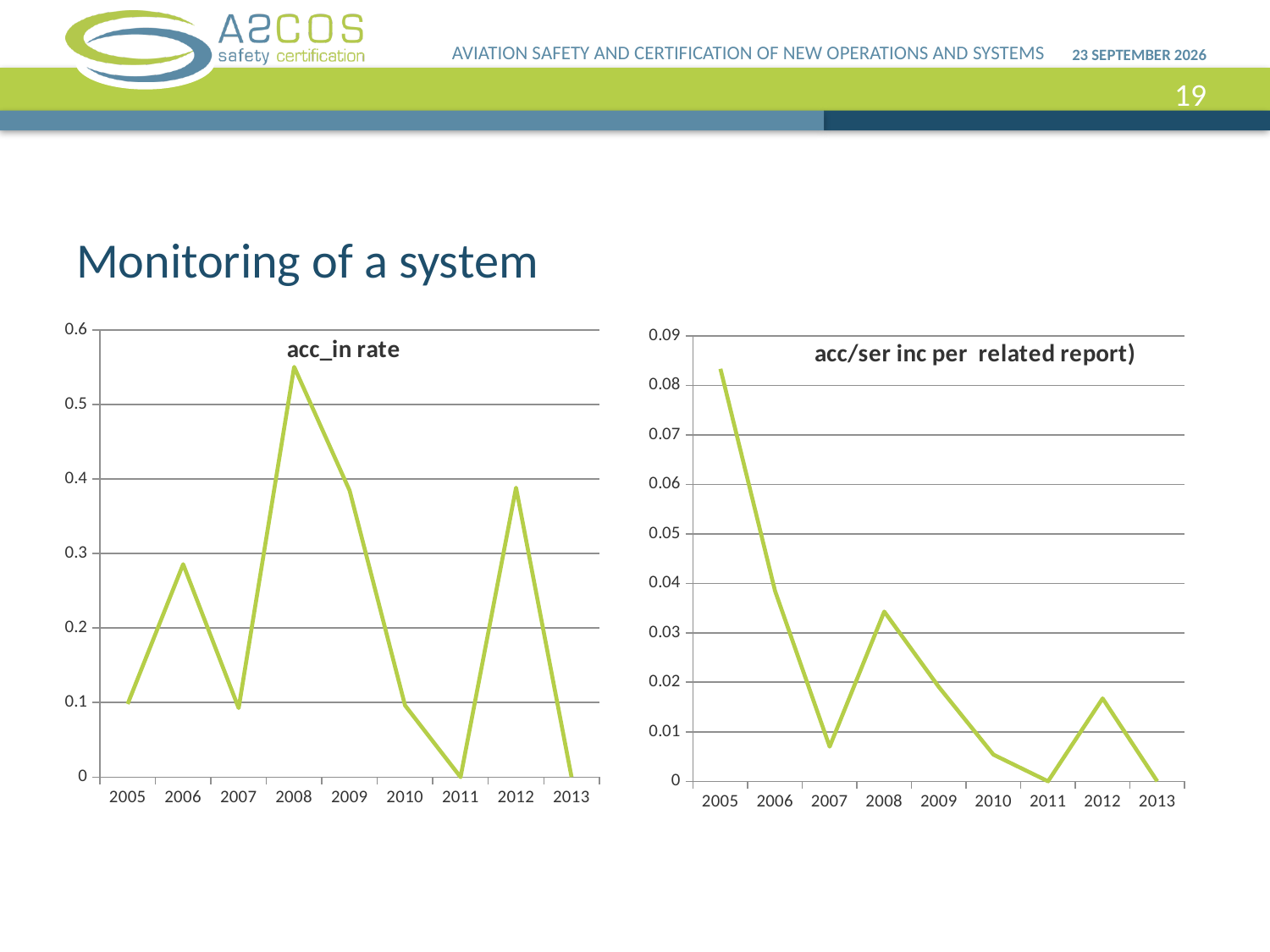
In the left chart "acc_in rate", what is the value for 2011? 0 In the left chart "acc_in rate", which year has the highest value? 2008 In the right chart "acc/ser inc per related report)", which year has the highest value? 2005 In the left chart "acc_in rate", is the value for 2006 greater or less than 0.3? less In the right chart "acc/ser inc per related report)", do the values overall rise or fall from 2005 to 2013? fall In the left chart "acc_in rate", is the value for 2008 greater or less than 0.5? greater What is the title of the left chart? acc_in rate What kind of chart is the left chart titled "acc_in rate"? line chart In the right chart "acc/ser inc per related report)", which is larger, the value for 2008 or the value for 2012? 2008 How many years are plotted on the x axis of the left chart "acc_in rate"? 9 In the right chart "acc/ser inc per related report)", is the value for 2008 greater or less than 0.03? greater